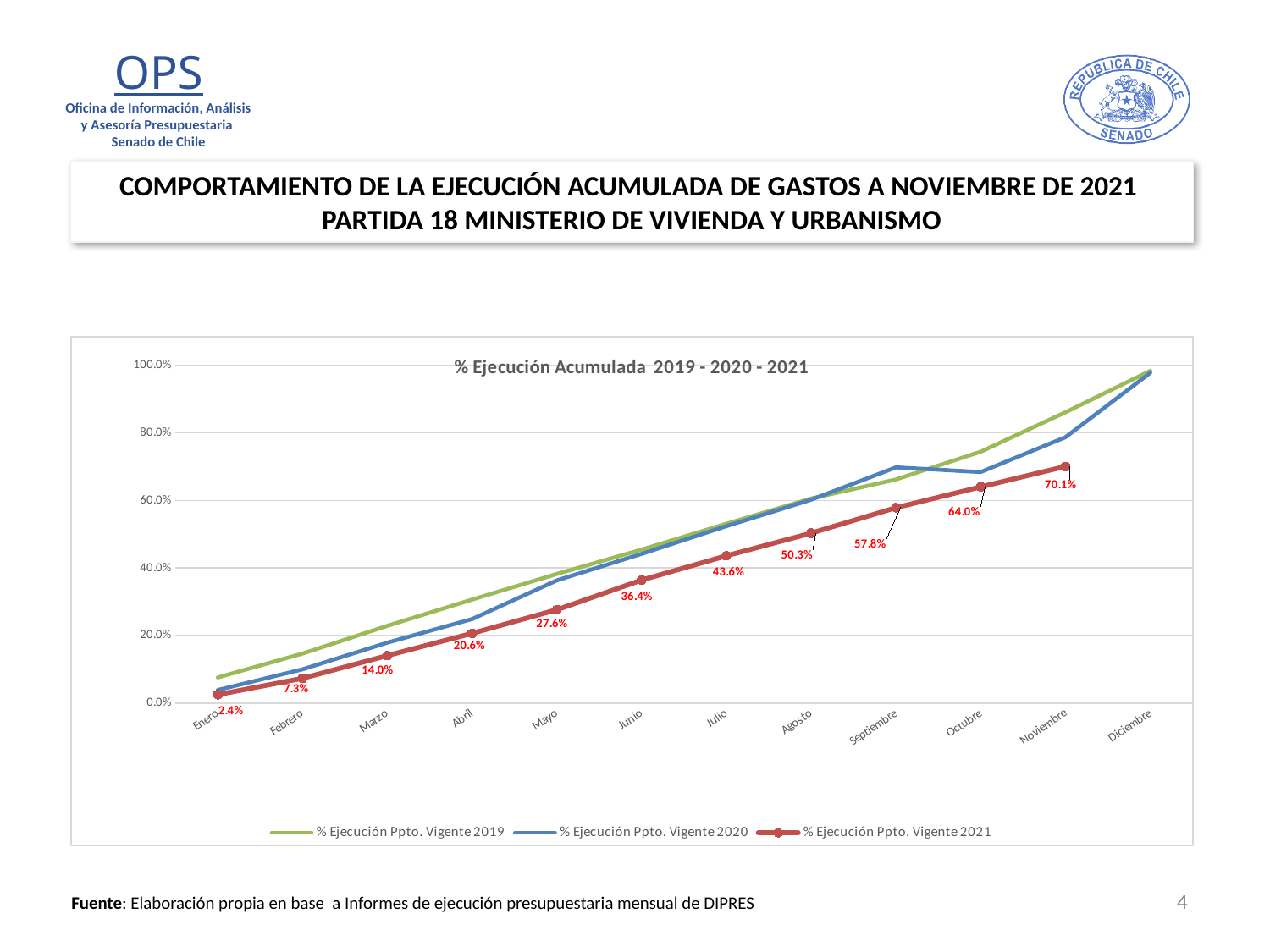
What type of chart is shown on the slide? line chart In Noviembre, which series has the larger value: % Ejecución Ppto. Vigente 2019 or % Ejecución Ppto. Vigente 2021? % Ejecución Ppto. Vigente 2019 Does the % Ejecución Ppto. Vigente 2021 series rise or fall from Enero to Noviembre? rise Which month has the lowest value for % Ejecución Ppto. Vigente 2021? Enero What is the title of the chart? % Ejecución Acumulada 2019 - 2020 - 2021 Is the value for % Ejecución Ppto. Vigente 2019 in Diciembre greater or less than 80.0%? greater What is the value of % Ejecución Ppto. Vigente 2021 for Junio? 36.4% What is the value of % Ejecución Ppto. Vigente 2021 for Enero? 2.4% How many months are shown on the x axis? 12 How many series does the legend list? 3 What is the value of % Ejecución Ppto. Vigente 2021 for Noviembre? 70.1% What is the difference between the 2021 values for Noviembre and Octubre? 6.1%